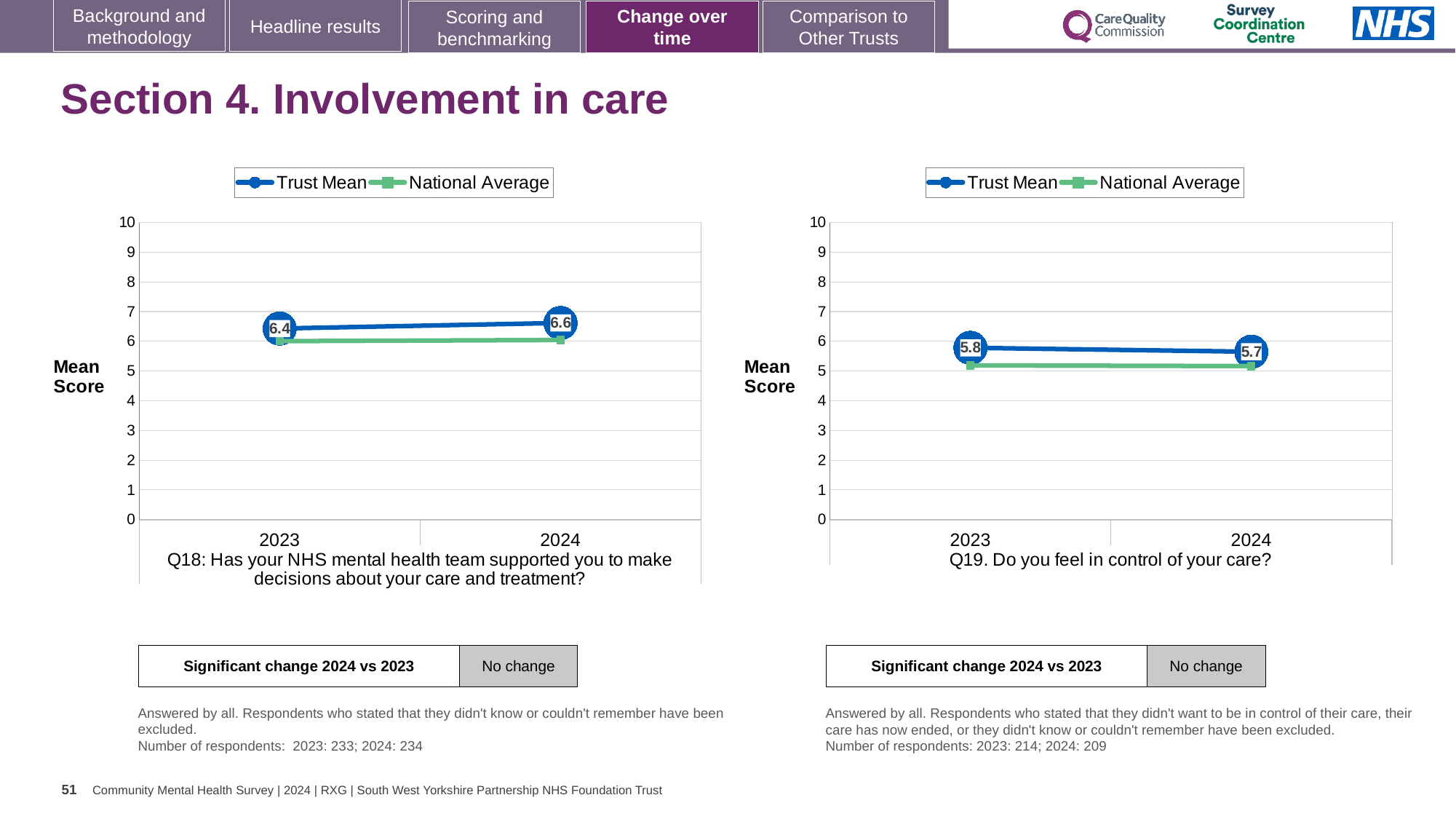
In the Q18 chart (left), by how much did the Trust Mean change from 2023 to 2024? 0.2 What kind of chart is the Q19 chart (right)? line chart How many series does the legend of the Q18 chart (left) list? 2 In the Q19 chart (right), what is the Trust Mean score for 2023? 5.8 In the Q19 chart (right), is the National Average for 2024 greater or less than 6? less In the Q18 chart (left), what is the Trust Mean score for 2024? 6.6 In the Q18 chart (left), what is the Trust Mean score for 2023? 6.4 In the Q19 chart (right), does the Trust Mean rise or fall from 2023 to 2024? fall How many years are shown on the x axis of the Q19 chart (right)? 2 In the Q19 chart (right), what is the Trust Mean score for 2024? 5.7 In the Q18 chart (left), does the Trust Mean rise or fall from 2023 to 2024? rise In the Q18 chart (left), which series is higher in 2024, Trust Mean or National Average? Trust Mean